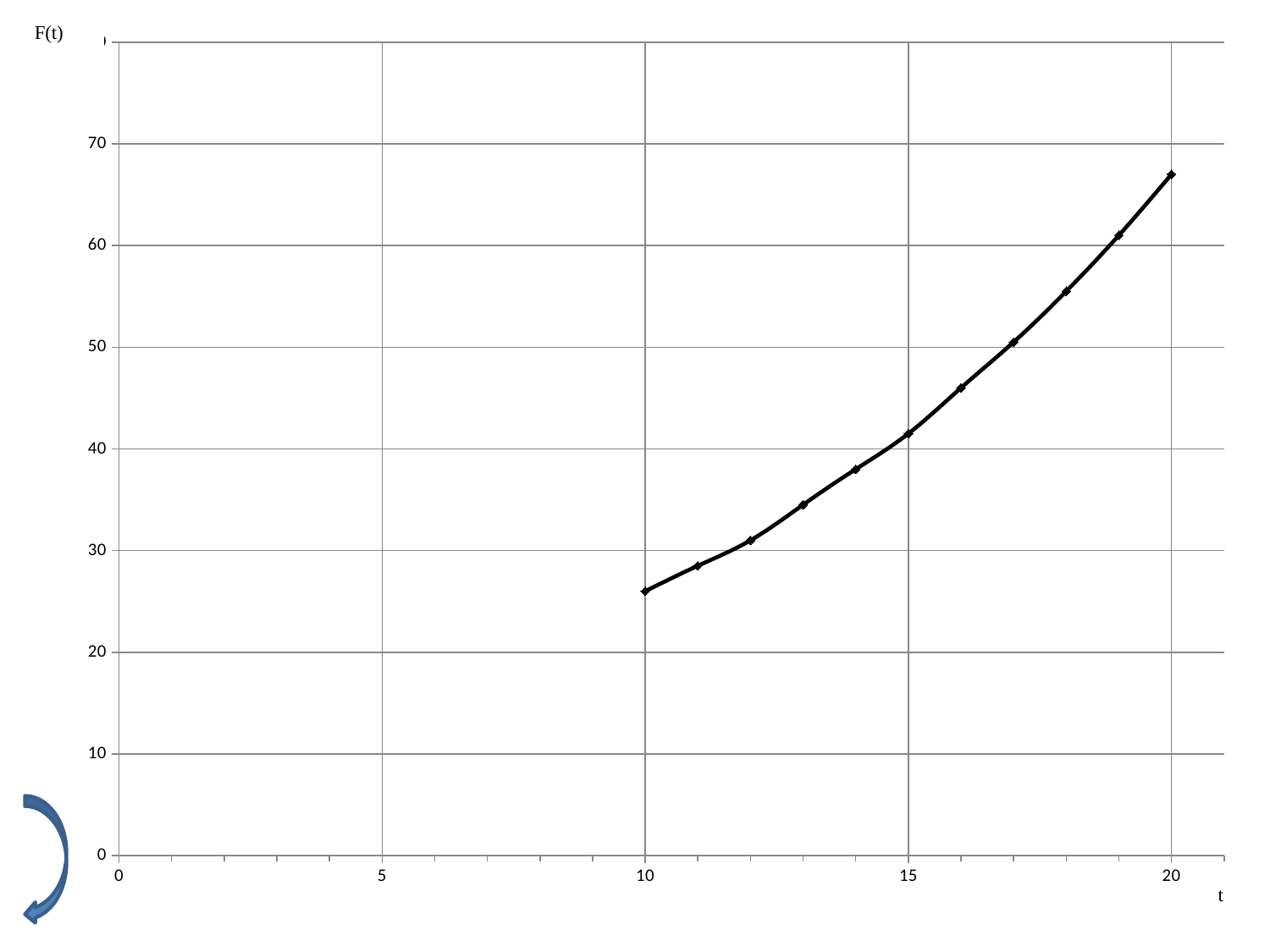
At which value of t is F(t) lowest? 10 Which is larger, F(t) at t = 20 or F(t) at t = 10? t = 20 Is the value of F(t) at t = 10 greater or less than 30? less Do the values of F(t) rise or fall as t increases from 10 to 20? rise What label is shown on the vertical axis of the chart? F(t) Is the value of F(t) at t = 15 greater or less than 40? greater How many data points are plotted on the line? 11 Is the value of F(t) at t = 18 greater or less than 50? greater What kind of chart is shown on the slide? line chart At which value of t is F(t) highest? 20